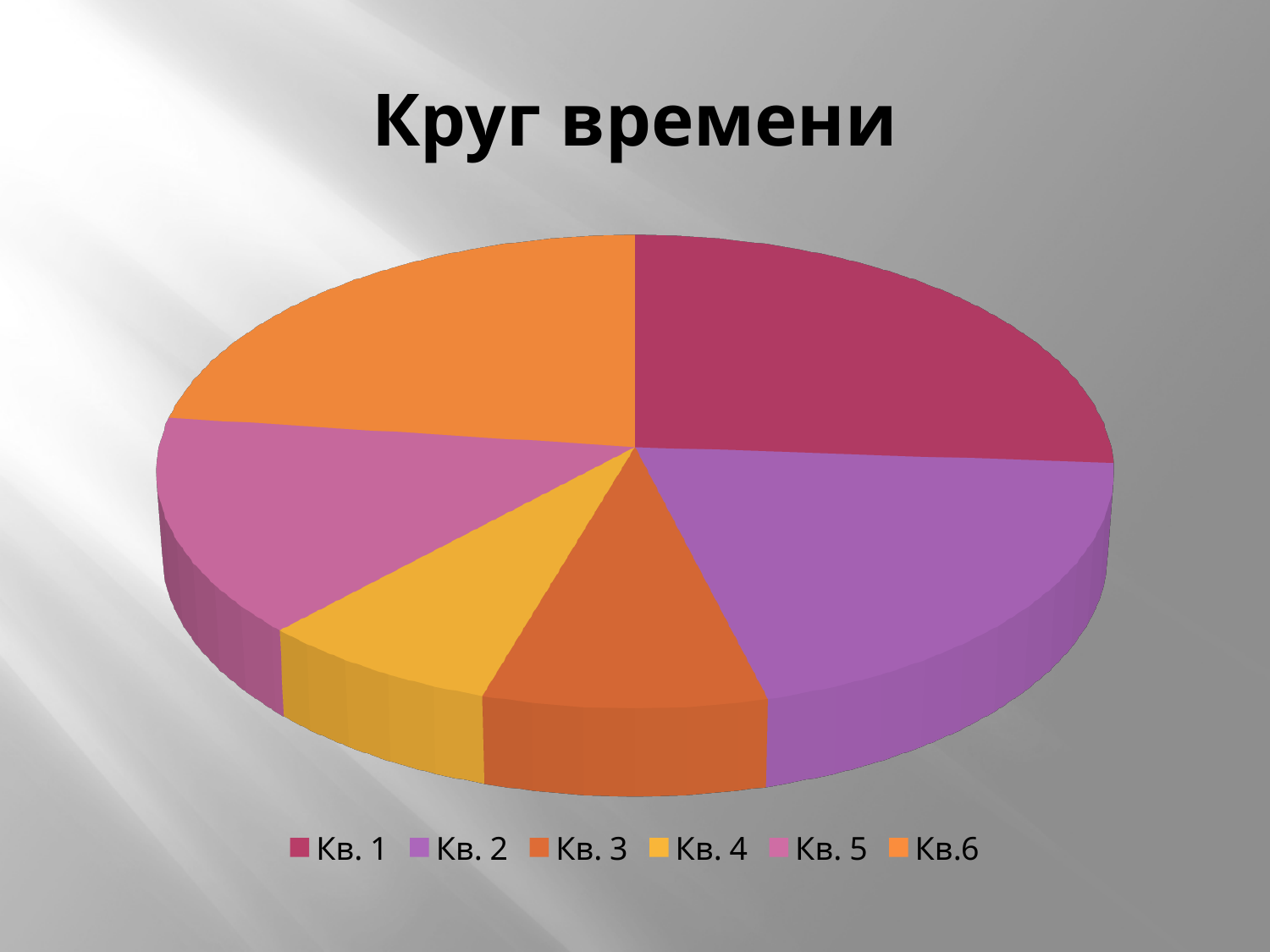
What is the title of the chart? Круг времени Which slice is larger, Кв. 1 or Кв. 4? Кв. 1 How many slices does the pie chart have? 6 How many entries does the legend list? 6 What colour is the slice for Кв. 4? yellow What kind of chart is shown on the slide? pie chart Which slice is larger, Кв.6 or Кв. 3? Кв.6 Which slice is larger, Кв. 2 or Кв. 3? Кв. 2 Which category has the smallest slice of the pie? Кв. 4